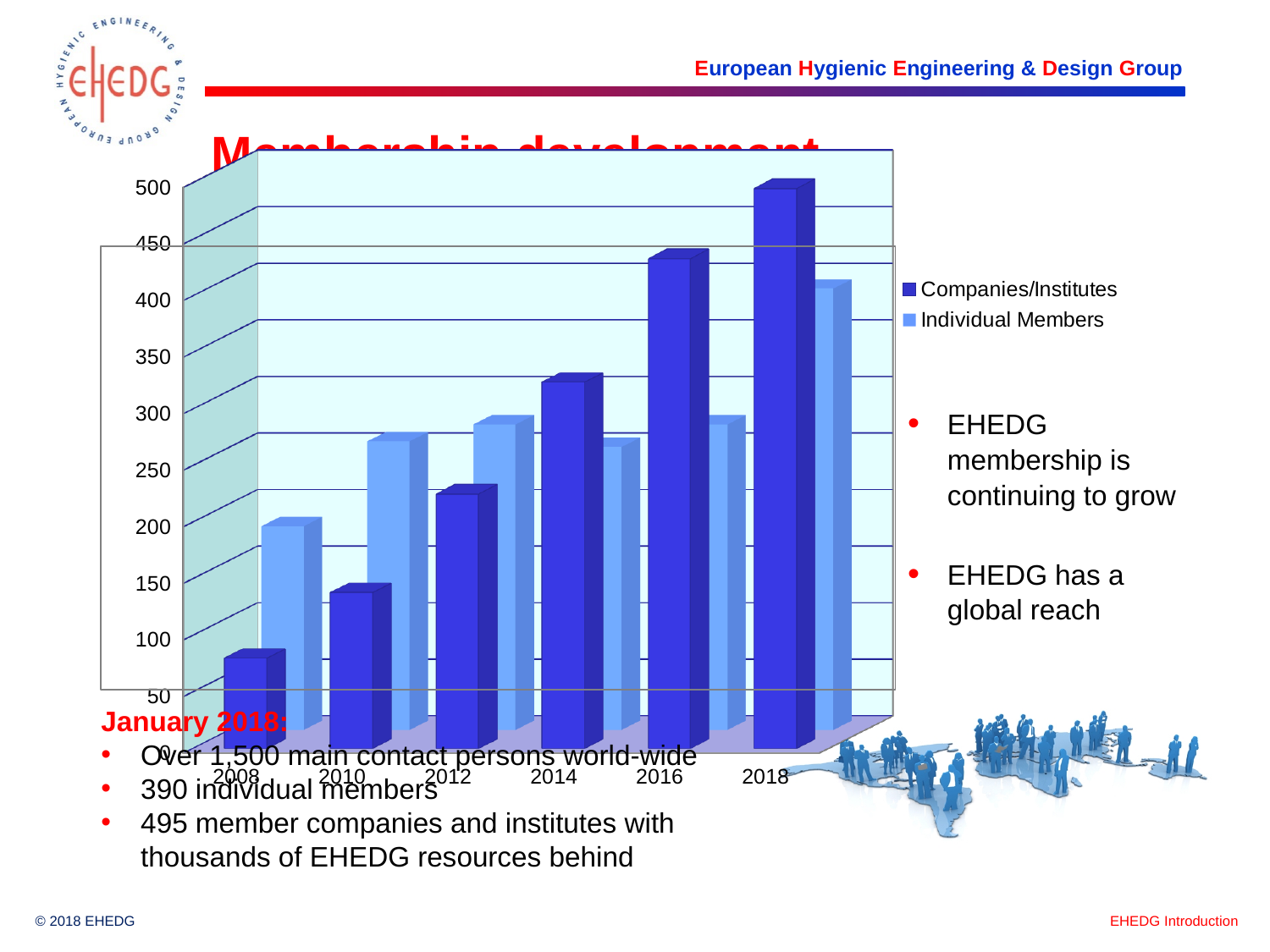
Is the value for Companies/Institutes in 2008 greater or less than 100? less Which year has the lowest value for Companies/Institutes? 2008 Is the value for Companies/Institutes in 2018 greater or less than 450? greater Is the value for Companies/Institutes in 2016 greater or less than 400? greater How many years are shown on the x axis of the chart? 6 Do the values for Companies/Institutes rise or fall from 2008 to 2018? rise In 2008, which series has the larger value, Companies/Institutes or Individual Members? Individual Members In 2018, which series has the larger value, Companies/Institutes or Individual Members? Companies/Institutes How many series does the chart legend list? 2 What kind of chart is shown on the slide? bar chart Which year has the highest value for Companies/Institutes? 2018